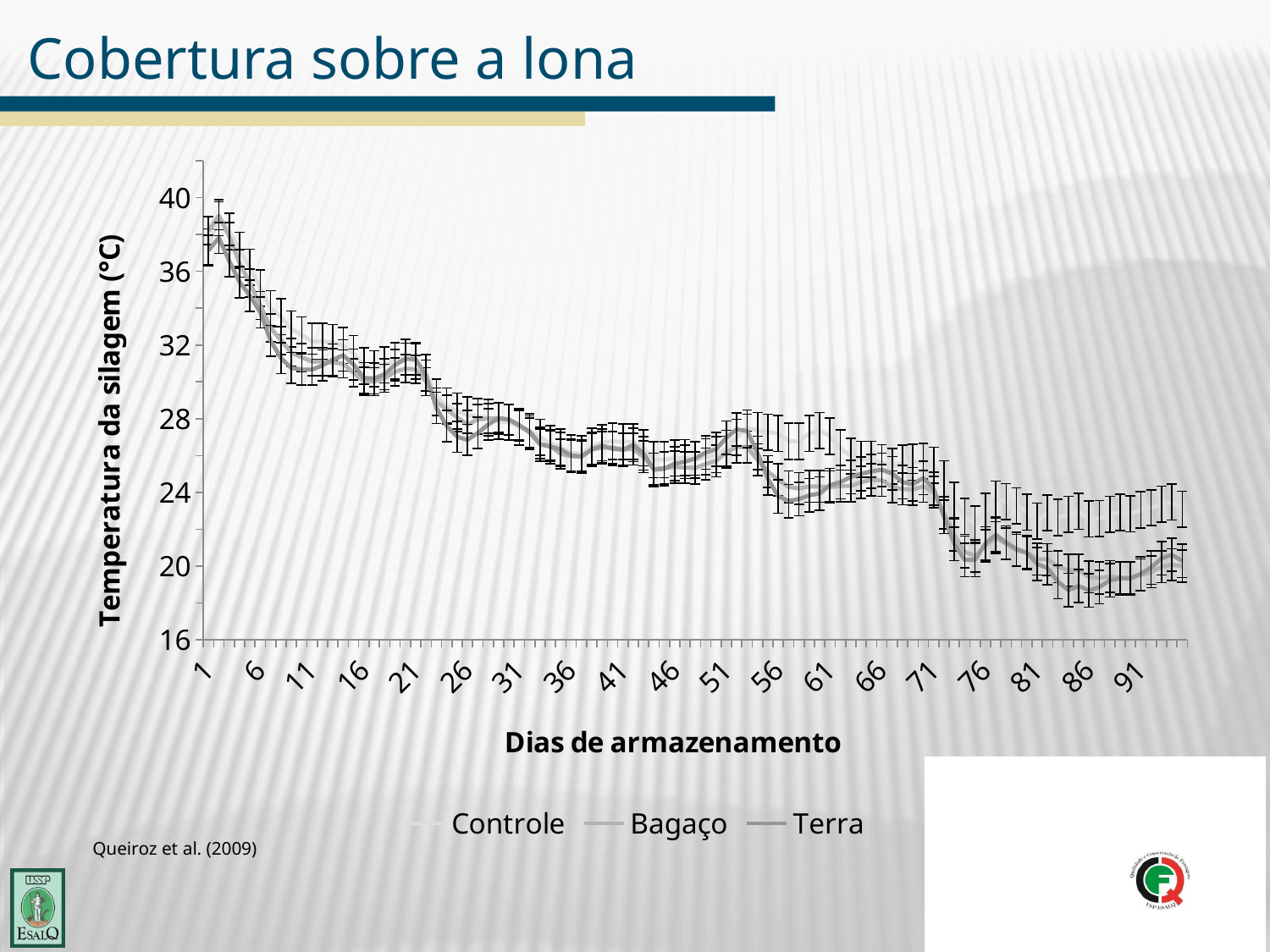
Are the temperature values at day 1 greater or less than 32? greater Are the temperature values at day 91 greater or less than 28? less What is the highest value shown on the y axis? 40 What is the title of the y axis? Temperatura da silagem (°C) Are the temperature values at day 26 greater or less than 24? greater How many series does the legend list? 3 Do the temperature values generally rise or fall as the storage days increase along the x axis? fall What are the series names listed in the legend? Controle, Bagaço, Terra Are the temperatures at day 1 higher or lower than the temperatures at day 86? higher What kind of chart is shown on the slide? line chart